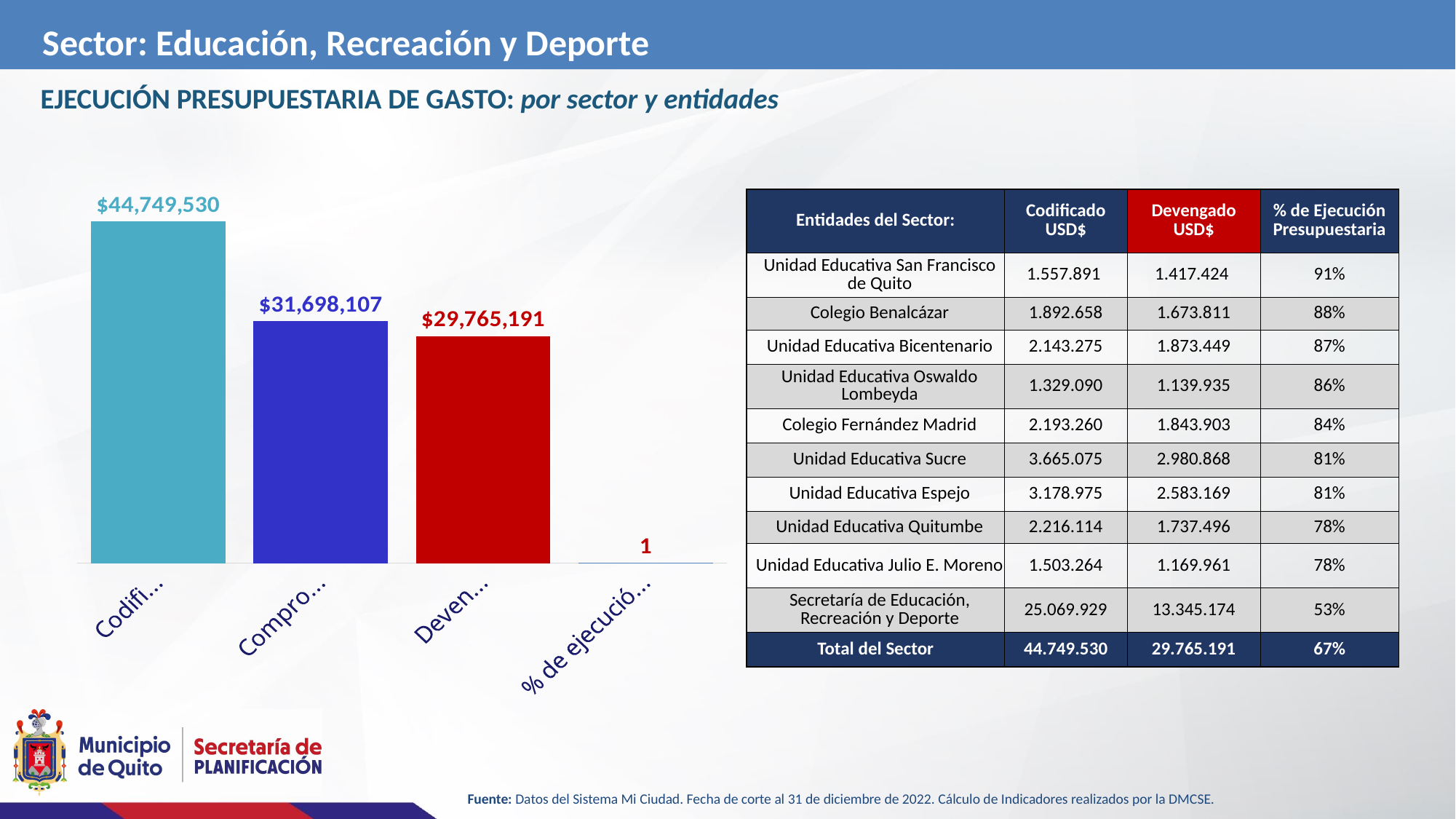
What value is printed for the last category (labelled "% de ejecució...") in the chart? 1 How many bars does the chart on the left of the slide have? 3 What is the value shown on the second bar (labelled "Compro...") of the chart? $31,698,107 What colour is the third bar (Deven...) in the chart? red Which category in the chart has the lowest value? % de ejecució... (the last category) What is the difference between the second bar ($31,698,107) and the third bar ($29,765,191) in the chart? $1,932,916 What kind of chart is shown on the left of the slide? bar chart What is the value shown on the first bar (labelled "Codifi...") of the chart? $44,749,530 Which bar in the chart has the highest value? Codifi... (the first bar) In the chart, which is larger: the second bar (Compro...) or the third bar (Deven...)? the second bar (Compro...) What is the value shown on the third bar (labelled "Deven...") of the chart? $29,765,191 What is the difference between the first bar ($44,749,530) and the second bar ($31,698,107) in the chart? $13,051,423